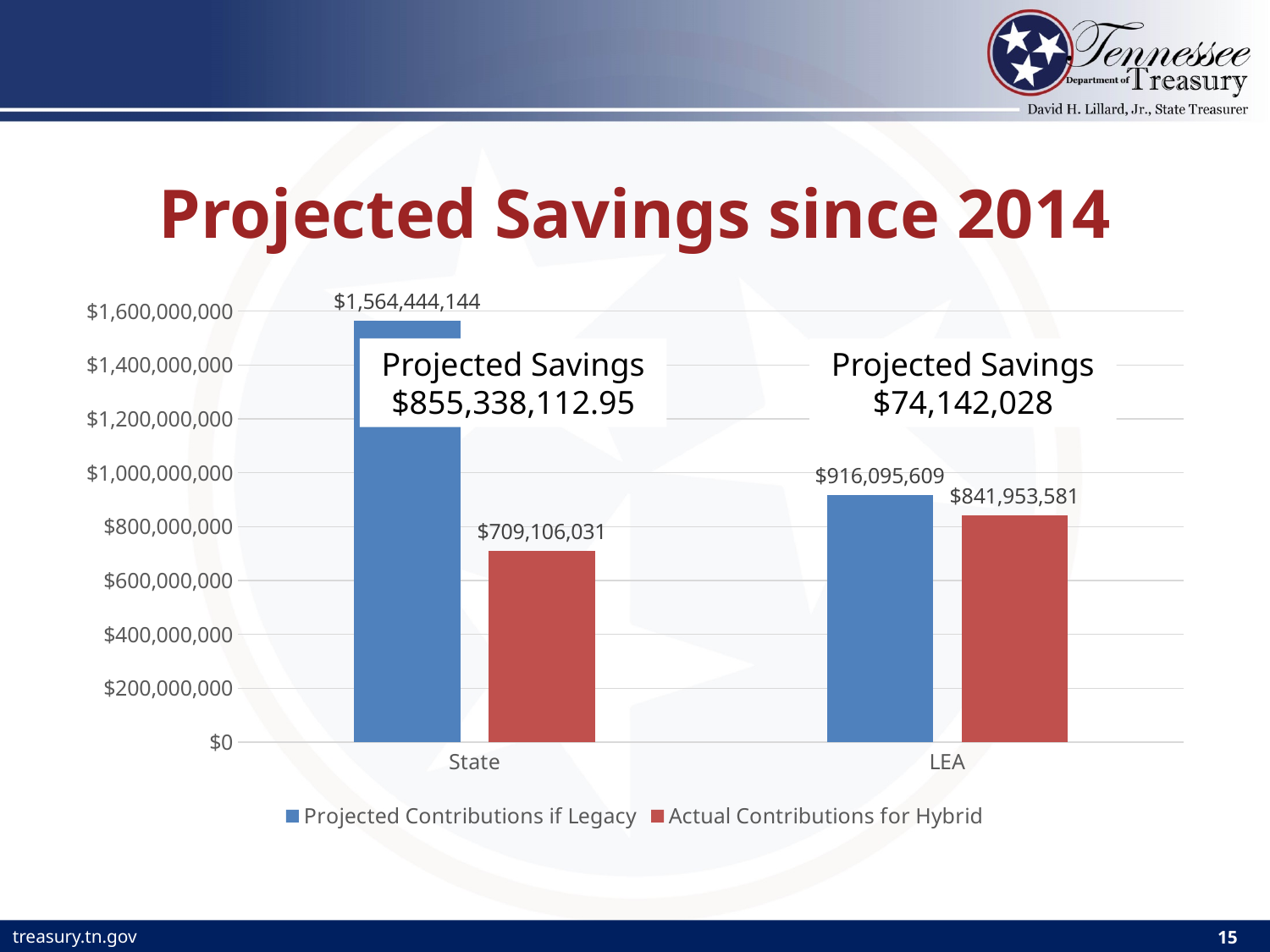
What is the value of Projected Contributions if Legacy for State? $1,564,444,144 What is the value of Actual Contributions for Hybrid for LEA? $841,953,581 What is the difference between Projected Contributions if Legacy and Actual Contributions for Hybrid for LEA? $74,142,028 What Projected Savings amount is shown in the text box above the State bars? $855,338,112.95 How many series does the legend list? 2 Which is larger for LEA: Projected Contributions if Legacy or Actual Contributions for Hybrid? Projected Contributions if Legacy Which bar has the lowest value in the chart? Actual Contributions for Hybrid for State How many categories are shown on the x axis? 2 Which bar has the highest value in the chart? Projected Contributions if Legacy for State What is the value of Projected Contributions if Legacy for LEA? $916,095,609 What type of chart is shown on the slide? Bar chart What is the value of Actual Contributions for Hybrid for State? $709,106,031